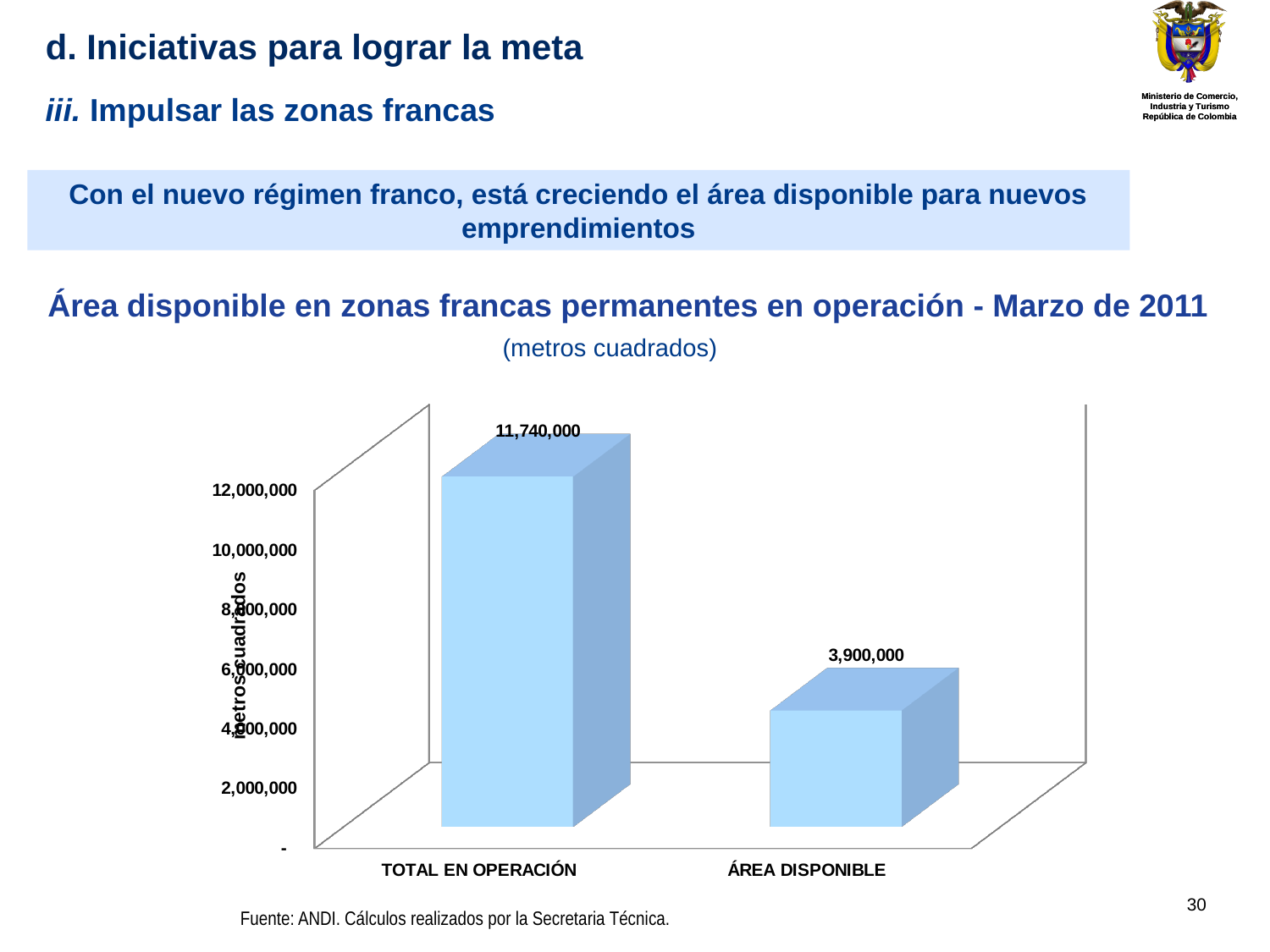
What is the value for ÁREA DISPONIBLE? 3,900,000 Which category has the lowest value? ÁREA DISPONIBLE How many categories are shown in the chart? 2 Which category has the highest value? TOTAL EN OPERACIÓN Is the value for ÁREA DISPONIBLE greater or less than 4,000,000? less What is the value for TOTAL EN OPERACIÓN? 11,740,000 What unit is the chart measured in, according to the subtitle? metros cuadrados What is the difference between TOTAL EN OPERACIÓN and ÁREA DISPONIBLE? 7,840,000 What is the title of the chart? Área disponible en zonas francas permanentes en operación - Marzo de 2011 Which is larger, TOTAL EN OPERACIÓN or ÁREA DISPONIBLE? TOTAL EN OPERACIÓN Is the value for TOTAL EN OPERACIÓN greater or less than 10,000,000? greater What kind of chart is shown on the slide? Bar chart